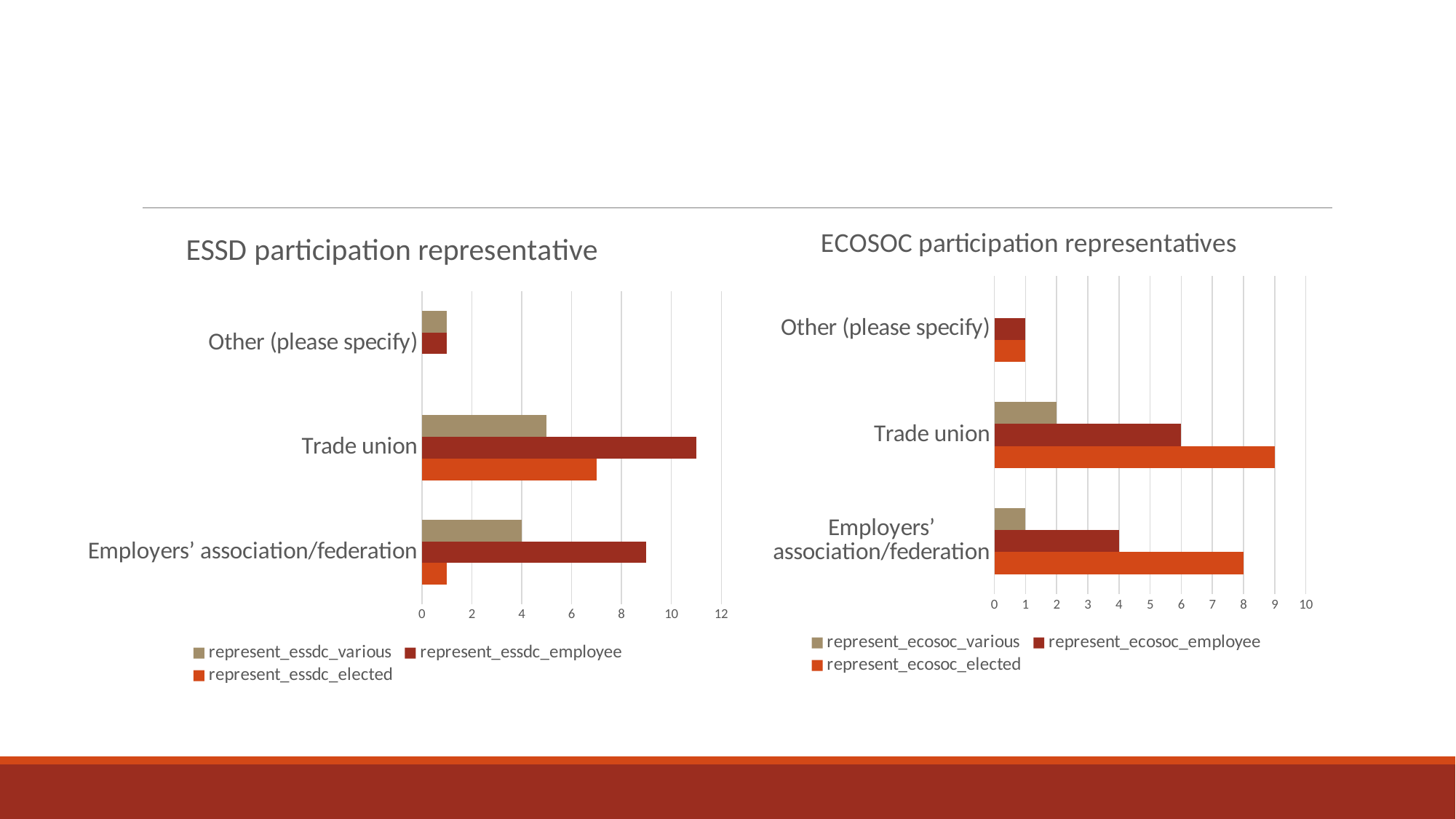
In the ESSD participation representative chart, is the represent_essdc_elected value for Employers' association/federation greater or less than 2? less In the ESSD participation representative chart, is the represent_essdc_employee value for Trade union greater or less than 10? greater In the ECOSOC participation representatives chart, which category has the highest represent_ecosoc_elected value? Trade union How many series does the legend of the ESSD participation representative chart list? 3 In the ECOSOC participation representatives chart, what is the value of represent_ecosoc_elected for Trade union? 9 In the ESSD participation representative chart, is the represent_essdc_employee value for Employers' association/federation larger or smaller than the represent_essdc_various value for the same category? larger In the ECOSOC participation representatives chart, what is the difference between represent_ecosoc_elected and represent_ecosoc_employee for Trade union? 3 How many categories are shown on the ECOSOC participation representatives chart? 3 In the ESSD participation representative chart, which series has the largest value for Trade union? represent_essdc_employee What kind of chart is the ESSD participation representative chart? Bar chart In the ECOSOC participation representatives chart, what is the value of represent_ecosoc_various for Trade union? 2 In the ECOSOC participation representatives chart, what is the value of represent_ecosoc_employee for Employers' association/federation? 4